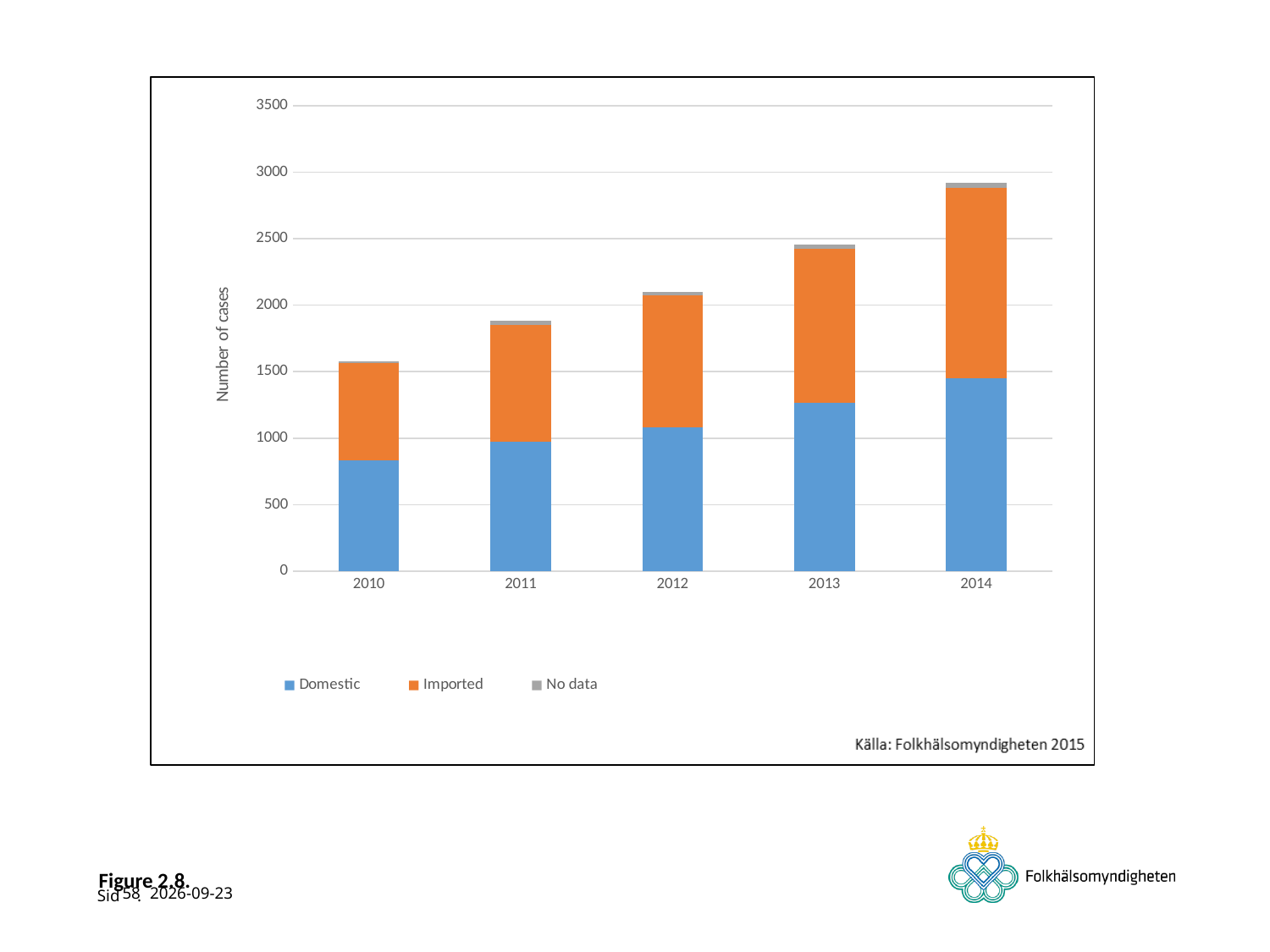
How many series does the legend list? 3 Is the total number of cases for 2014 greater or less than 2500? greater How many years are shown on the x axis of the chart? 5 Which year has the highest total number of cases? 2014 Is the total number of cases for 2010 greater or less than 2000? less Is the Domestic value for 2013 greater or less than 1000? greater What is the label of the y axis? Number of cases Do the total number of cases rise or fall from 2010 to 2014? Rise Which year has the lowest total number of cases? 2010 What kind of chart is shown on the slide? Stacked bar chart